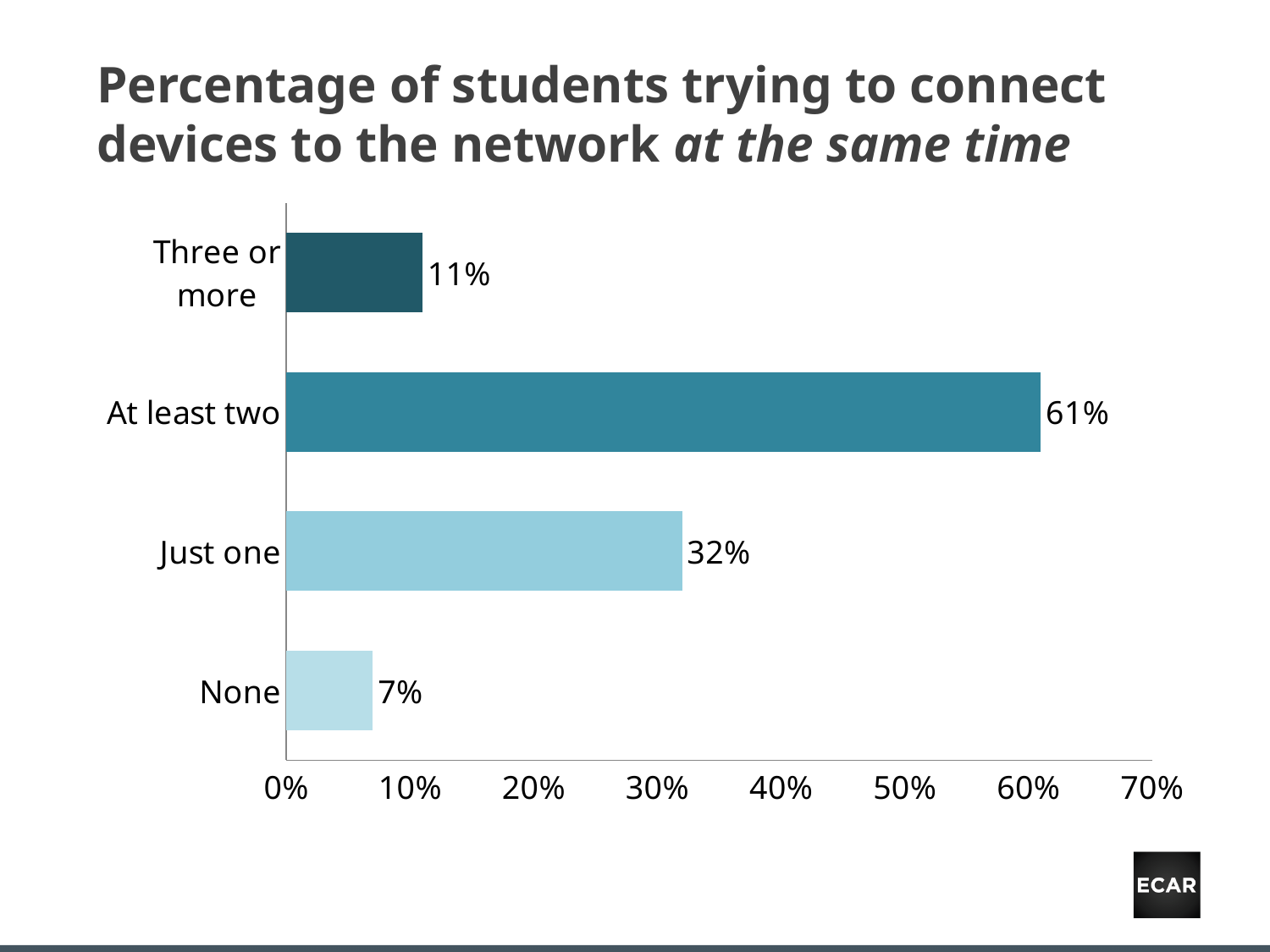
What is the difference between the 'Three or more' and 'None' values? 4% What is the maximum value shown on the horizontal axis? 70% How many categories are shown in the chart? 4 Which is larger, the value for 'Just one' or the value for 'Three or more'? Just one Which category has the highest percentage? At least two What percentage of students connect three or more devices at the same time? 11% What is the value for the 'Just one' category? 32% Which category has the lowest percentage? None What is the value shown for 'None'? 7% What is the difference between the 'At least two' and 'Just one' values? 29% What kind of chart is shown on the slide? Bar chart What percentage of students try to connect at least two devices to the network at the same time? 61%